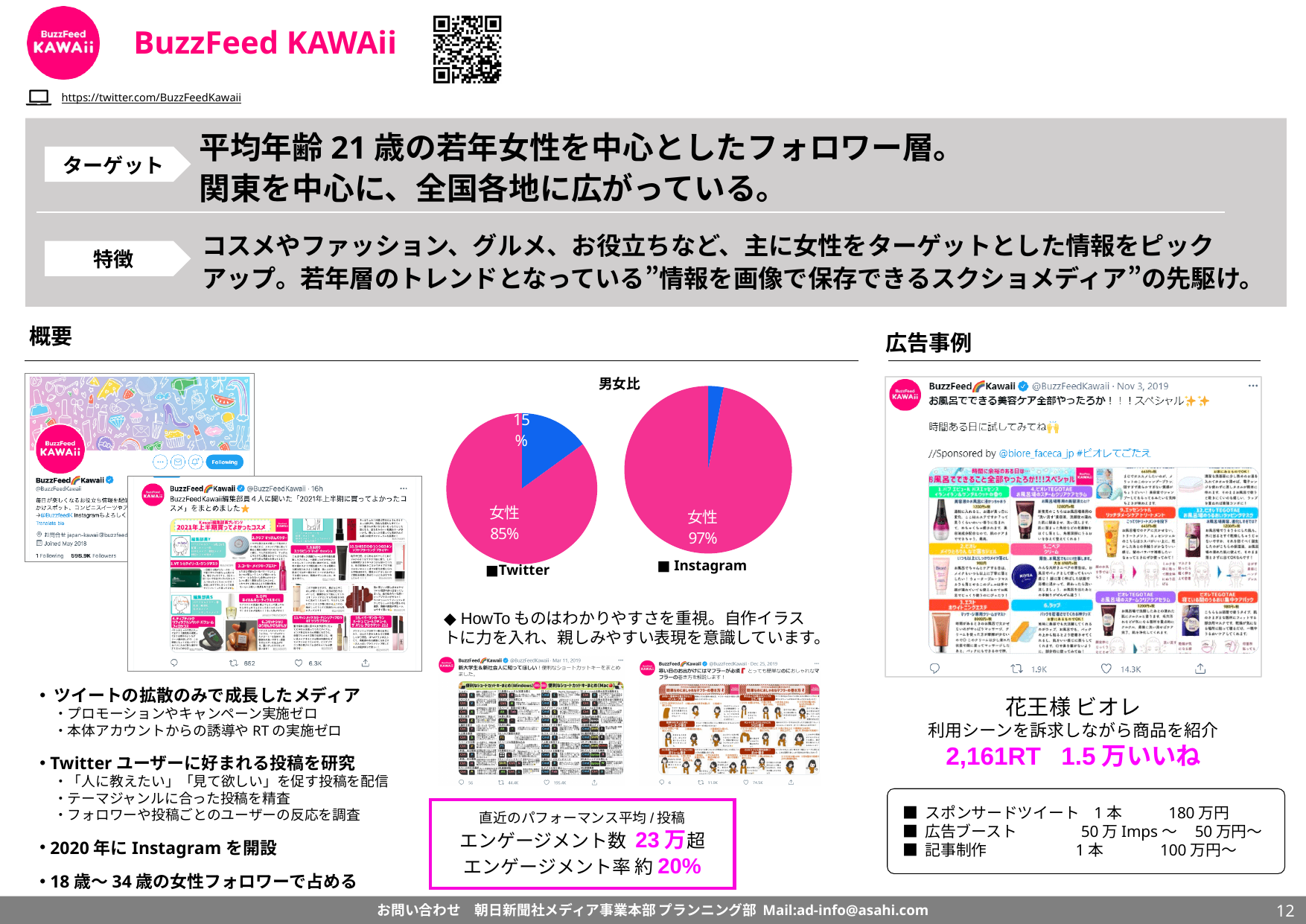
In the Twitter pie chart, what is the difference between the 女性 slice and the blue slice? 70 percentage points What colour is the 女性 slice in both pie charts? Pink Which pie chart, Twitter or Instagram, shows the larger share for 女性? Instagram By how many percentage points does the 女性 share in the Instagram pie chart exceed the 女性 share in the Twitter pie chart? 12 percentage points In the Instagram pie chart, what share is labelled 女性? 97% How many slices does the Twitter pie chart have? 2 What is the title shown above the two pie charts? 男女比 What kind of charts are shown under the heading 男女比? Pie charts In the Twitter pie chart, what percentage is shown for the blue slice? 15% In the Instagram pie chart, which slice is the smallest? The blue slice In the Twitter pie chart, which slice is the largest? 女性 In the Twitter pie chart, what share is labelled 女性? 85%